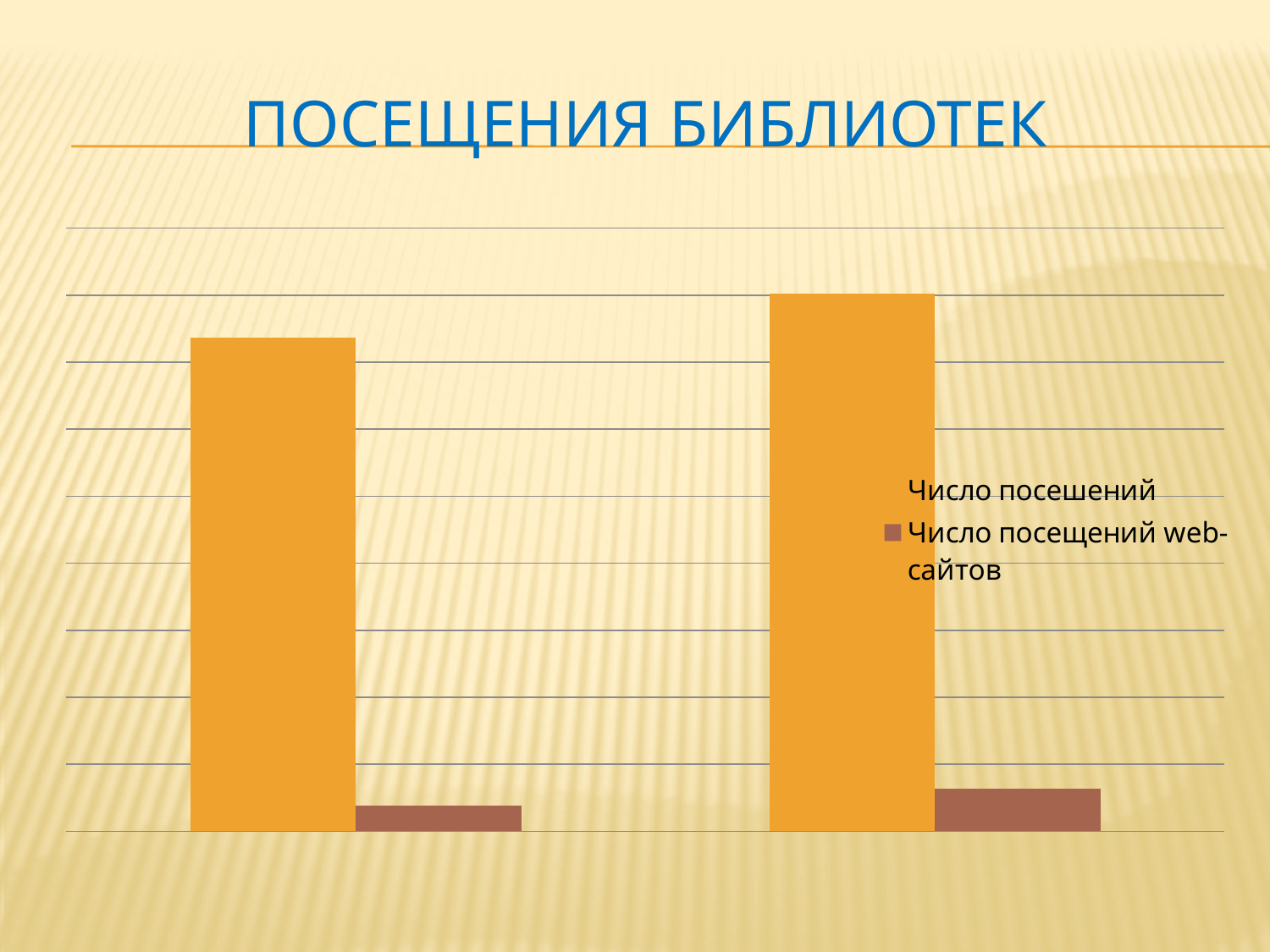
For the series 'Число посещений web-сайтов', is the bar in the left group or the right group taller? right Do the values for 'Число посешений' rise or fall from the left group to the right group? rise Which series has the tallest bar in the chart? Число посешений What is the title of the slide containing the chart? ПОСЕЩЕНИЯ БИБЛИОТЕК Do the values for 'Число посещений web-сайтов' rise or fall from the left group to the right group? rise In the right group of bars, which series has the smaller value? Число посещений web-сайтов Which series is shown in brown according to the legend? Число посещений web-сайтов In the left group of bars, which series has the larger value? Число посешений What kind of chart is shown on the slide? bar chart How many groups of bars are plotted in the chart? 2 How many series does the legend list? 2